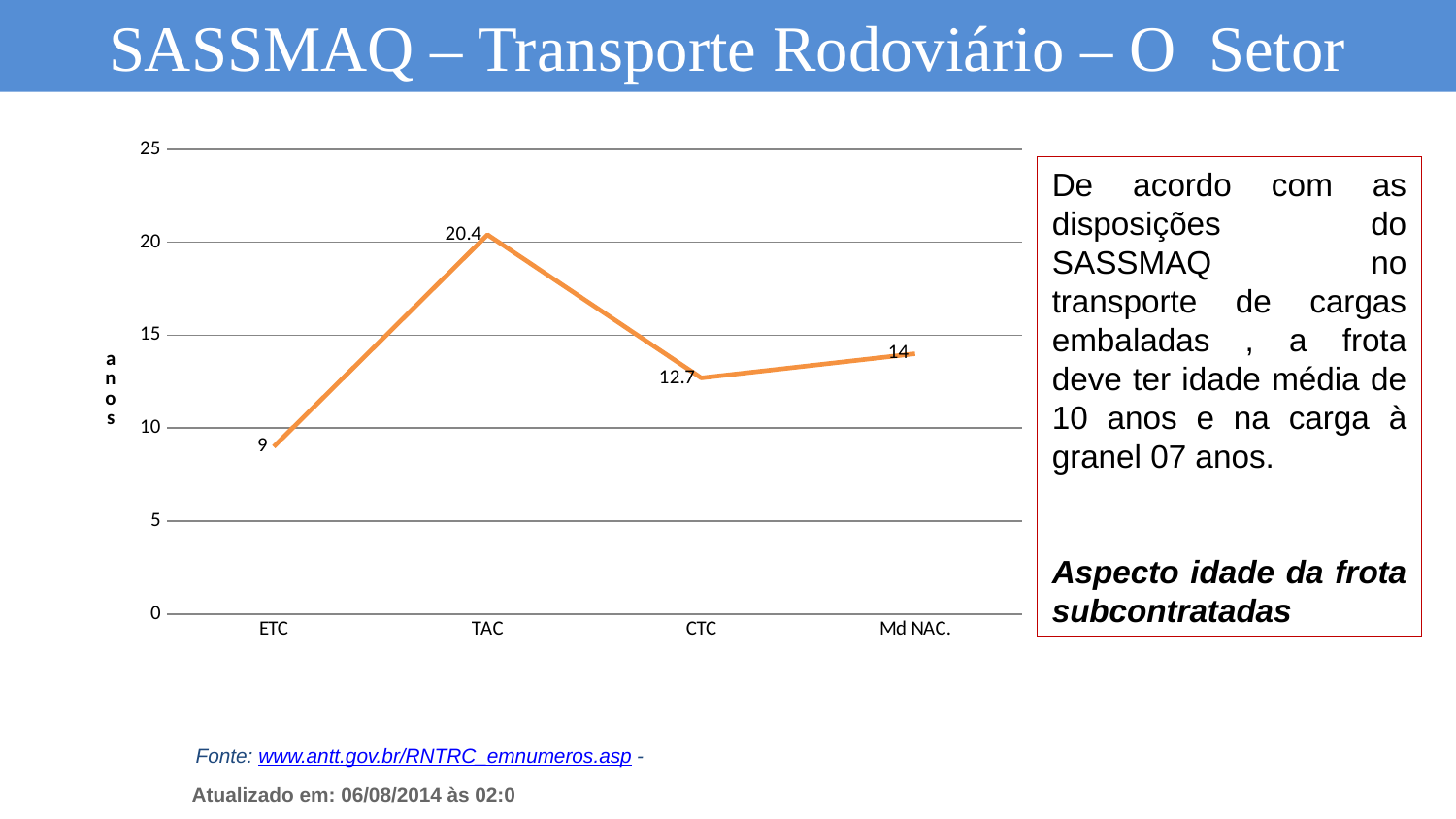
What is the label on the vertical axis of the chart? anos What is the value for TAC? 20.4 Is the value for TAC greater or less than 20? greater What is the difference between the values for TAC and ETC? 11.4 What is the value for ETC? 9 Which is larger, the value for CTC or the value for Md NAC.? Md NAC. Which category has the lowest value? ETC What is the value for CTC? 12.7 How many categories are plotted on the x axis? 4 Which category has the highest value? TAC What kind of chart is shown on the slide? line chart What is the value for Md NAC.? 14